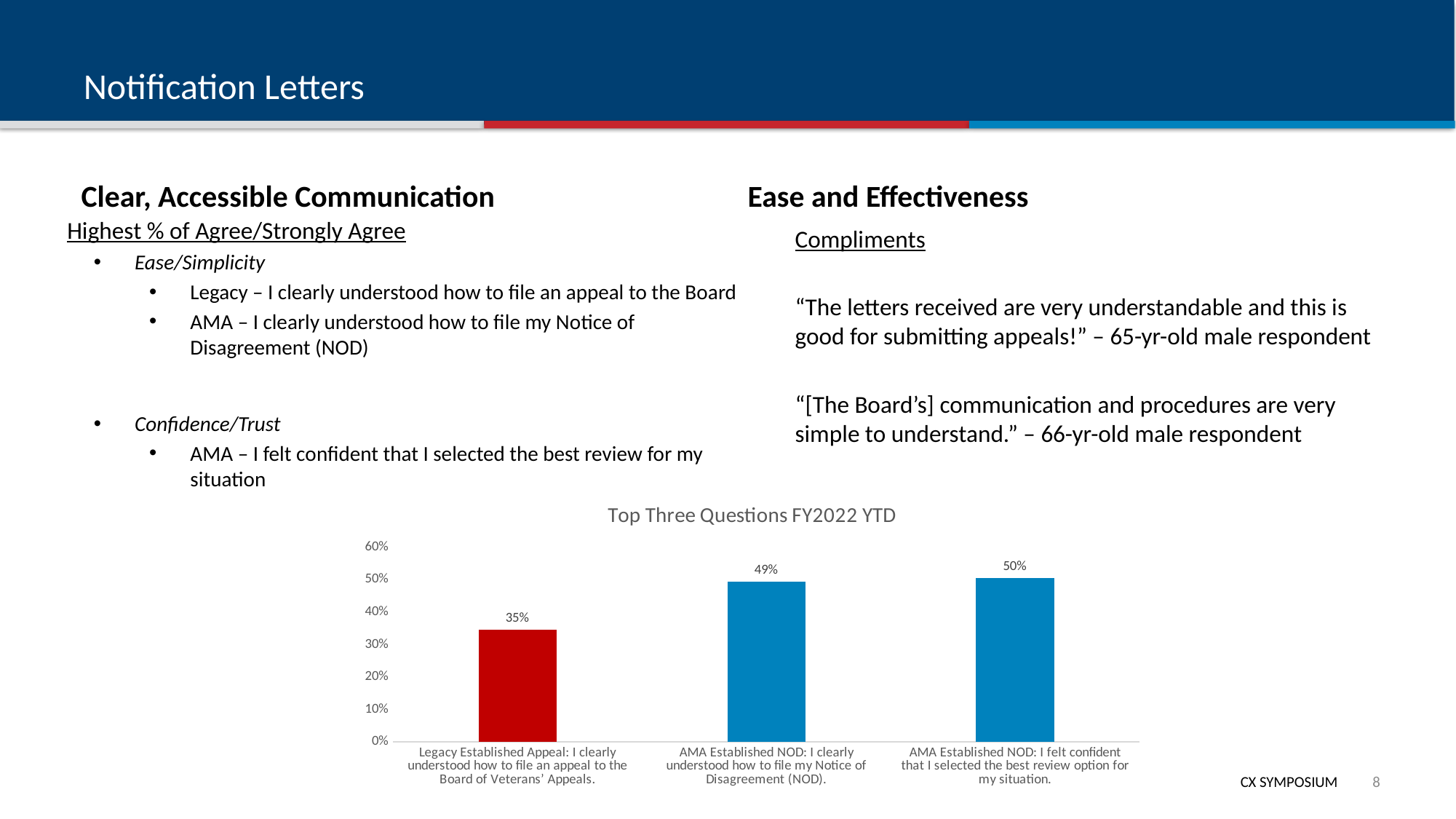
What is the value for "AMA Established NOD: I clearly understood how to file my Notice of Disagreement (NOD)."? 49% How many bars are plotted in the chart? 3 What is the title of the chart on the slide? Top Three Questions FY2022 YTD What is the value for "AMA Established NOD: I felt confident that I selected the best review option for my situation."? 50% What type of chart is shown on the slide? bar chart Which category has the lowest value in the chart? Legacy Established Appeal: I clearly understood how to file an appeal to the Board of Veterans' Appeals. Is the value for "Legacy Established Appeal: I clearly understood how to file an appeal to the Board of Veterans' Appeals." greater or less than 40%? less What is the value for "Legacy Established Appeal: I clearly understood how to file an appeal to the Board of Veterans' Appeals."? 35% What is the difference between the value for "AMA Established NOD: I felt confident that I selected the best review option for my situation." and the value for "Legacy Established Appeal: I clearly understood how to file an appeal to the Board of Veterans' Appeals."? 15% What colour is the bar for "Legacy Established Appeal: I clearly understood how to file an appeal to the Board of Veterans' Appeals."? red What is the difference between the value for "AMA Established NOD: I clearly understood how to file my Notice of Disagreement (NOD)." and the value for "Legacy Established Appeal: I clearly understood how to file an appeal to the Board of Veterans' Appeals."? 14% Which is larger: the value for "Legacy Established Appeal: I clearly understood how to file an appeal to the Board of Veterans' Appeals." or the value for "AMA Established NOD: I clearly understood how to file my Notice of Disagreement (NOD)."? AMA Established NOD: I clearly understood how to file my Notice of Disagreement (NOD).